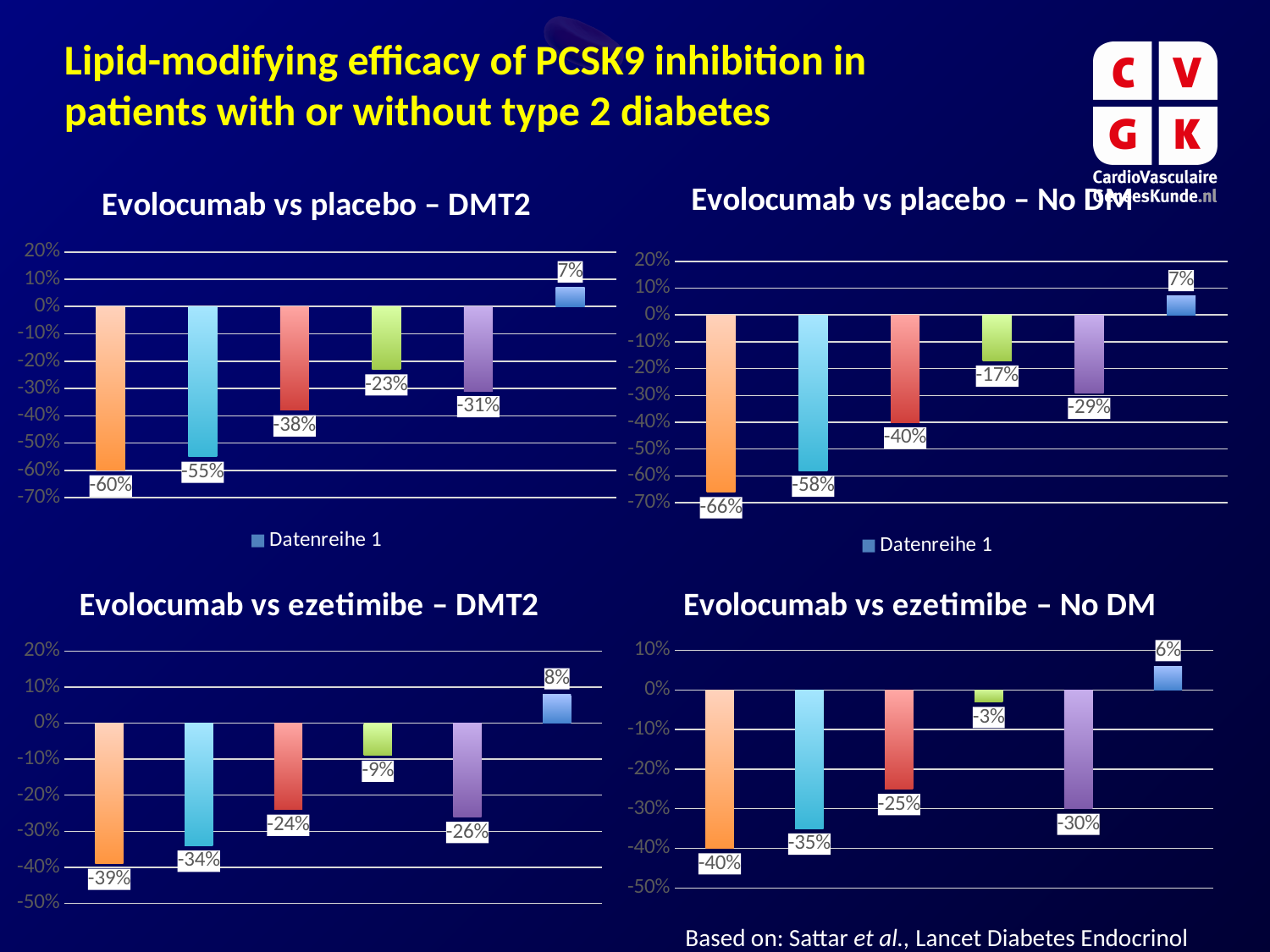
In the 'Evolocumab vs ezetimibe – DMT2' chart, what is the value of the purple bar? -26% In the 'Evolocumab vs placebo – No DM' chart, which bar shows the larger reduction, the red bar or the purple bar? The red bar (-40%) How many bars are plotted in the 'Evolocumab vs ezetimibe – No DM' chart? 6 In the 'Evolocumab vs placebo – DMT2' chart, what is the value of the first (orange) bar? -60% What type of chart is 'Evolocumab vs placebo – DMT2'? Bar chart In the 'Evolocumab vs ezetimibe – No DM' chart, what is the value of the green bar? -3% How many series does the legend of the 'Evolocumab vs placebo – DMT2' chart list? 1 In the 'Evolocumab vs placebo – No DM' chart, what is the lowest value shown? -66% What is the legend entry shown under the 'Evolocumab vs placebo – No DM' chart? Datenreihe 1 In the 'Evolocumab vs placebo – DMT2' chart, what is the difference between the first bar (-60%) and the second bar (-55%)? 5 percentage points In the 'Evolocumab vs placebo – No DM' chart, what is the value of the last (blue) bar? 7% In the 'Evolocumab vs ezetimibe – DMT2' chart, what is the highest value shown? 8%